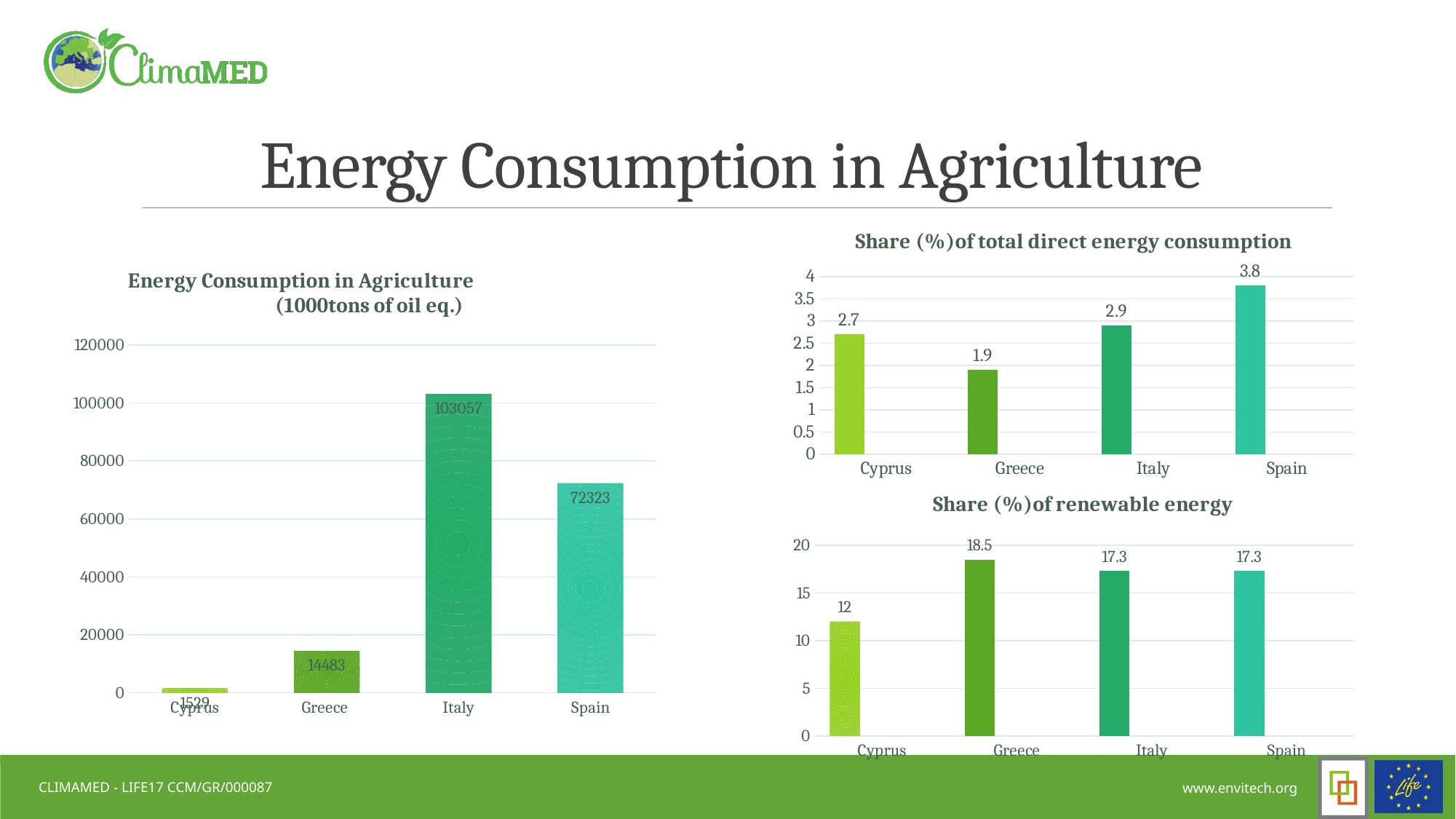
In the 'Energy Consumption in Agriculture (1000tons of oil eq.)' chart, what is the value for Greece? 14483 In the 'Share (%) of renewable energy' chart, what is the value for Cyprus? 12 In the 'Energy Consumption in Agriculture (1000tons of oil eq.)' chart, which country has the lowest value? Cyprus In the 'Energy Consumption in Agriculture (1000tons of oil eq.)' chart, what is the value for Italy? 103057 In the 'Share (%) of total direct energy consumption' chart, which country has the lowest share? Greece In the 'Share (%) of total direct energy consumption' chart, which is larger, Cyprus or Italy? Italy In the 'Share (%) of renewable energy' chart, which country has the highest share? Greece In the 'Share (%) of total direct energy consumption' chart, what is the value for Spain? 3.8 In the 'Share (%) of renewable energy' chart, what is the difference between Greece and Italy? 1.2 In the 'Energy Consumption in Agriculture (1000tons of oil eq.)' chart, what is the difference between Italy and Spain? 30734 What type of chart is the 'Energy Consumption in Agriculture (1000tons of oil eq.)' chart? Bar chart How many countries are shown in the 'Share (%) of renewable energy' chart? 4